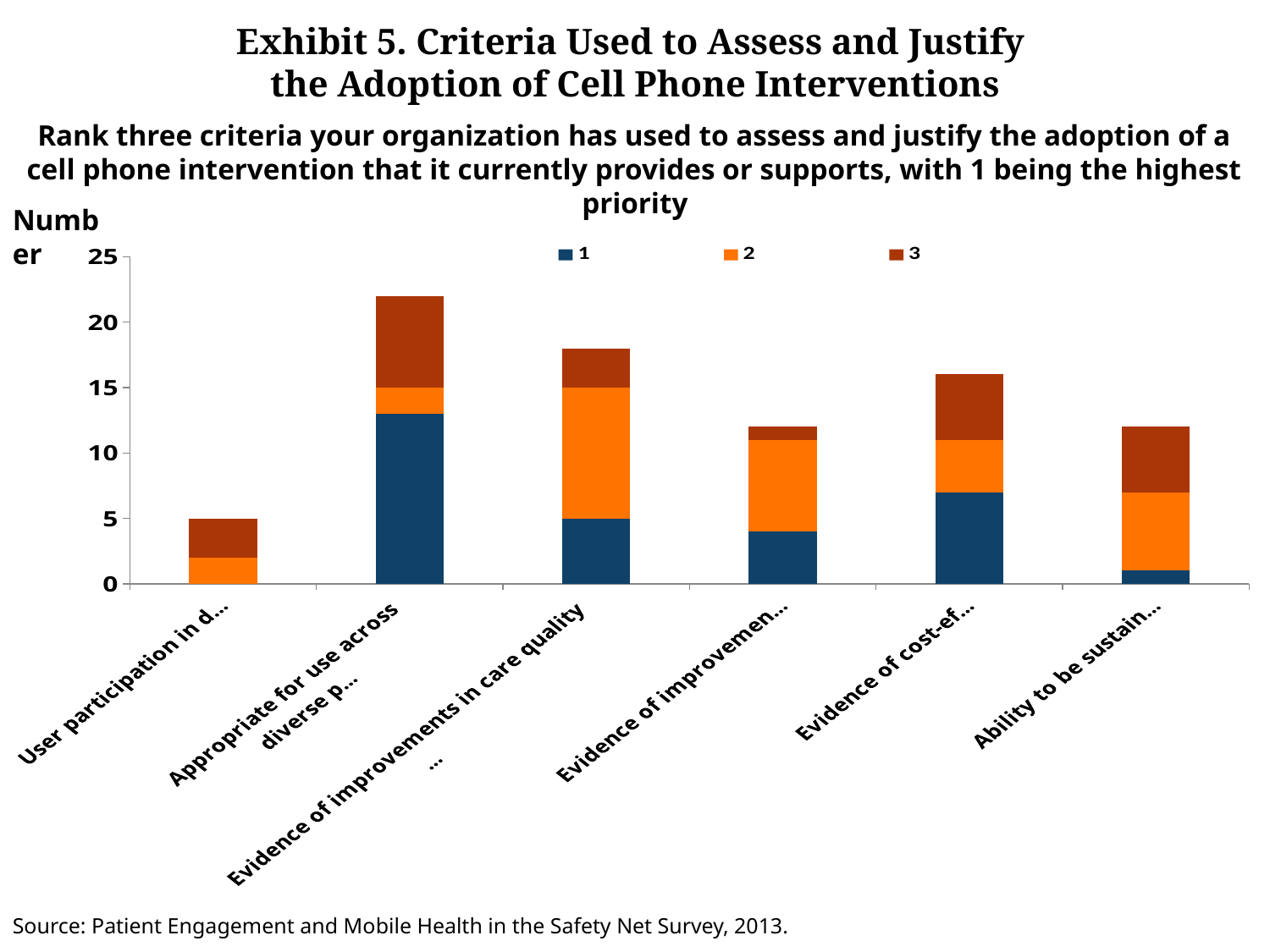
What are the legend entries for the three series? 1, 2, 3 What kind of chart is shown on the slide? Stacked bar chart What is the total height of the stacked bar for "User participation in d..."? 5 Is the total for "Evidence of improvements in care quality" greater or less than 20? less Which has the taller stacked bar: "Appropriate for use across diverse p..." or "Evidence of improvements in care quality"? Appropriate for use across diverse p... Which criterion has the shortest stacked bar overall? User participation in d... Is the total for "Appropriate for use across diverse p..." greater or less than 20? greater What is the label on the vertical axis? Number How many criteria (categories) are plotted along the x axis? 6 Is the total for "Ability to be sustain..." greater or less than 10? greater How many series does the legend list? 3 Which criterion has the tallest stacked bar overall? Appropriate for use across diverse p...